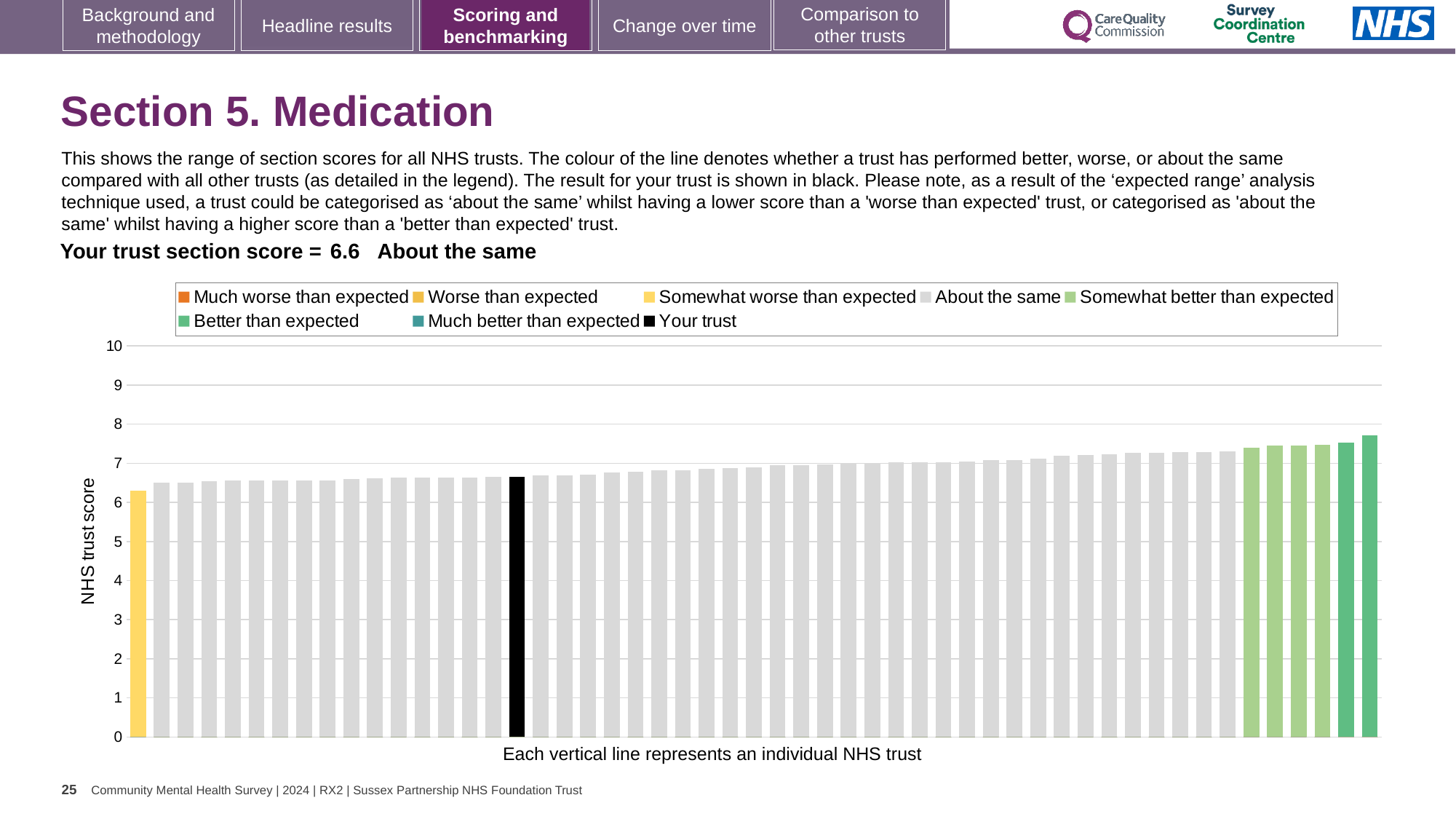
Is the value of the leftmost (yellow) bar greater or less than 6? greater Is the value of the tallest bar on the chart greater or less than 7? greater How many bars are coloured as 'Somewhat better than expected' (light green)? 4 What is the label on the vertical axis of the chart? NHS trust score Which is taller, the leftmost bar or the rightmost bar? the rightmost bar How many bars are coloured as 'Better than expected' (dark green)? 2 How many entries does the chart legend list? 8 Which category is your trust's section score placed in? About the same What kind of chart is shown on the slide? bar chart Is the value of the black 'Your trust' bar greater or less than 7? less Do the bar values rise or fall from left to right across the chart? rise What is your trust's section score for Section 5. Medication? 6.6